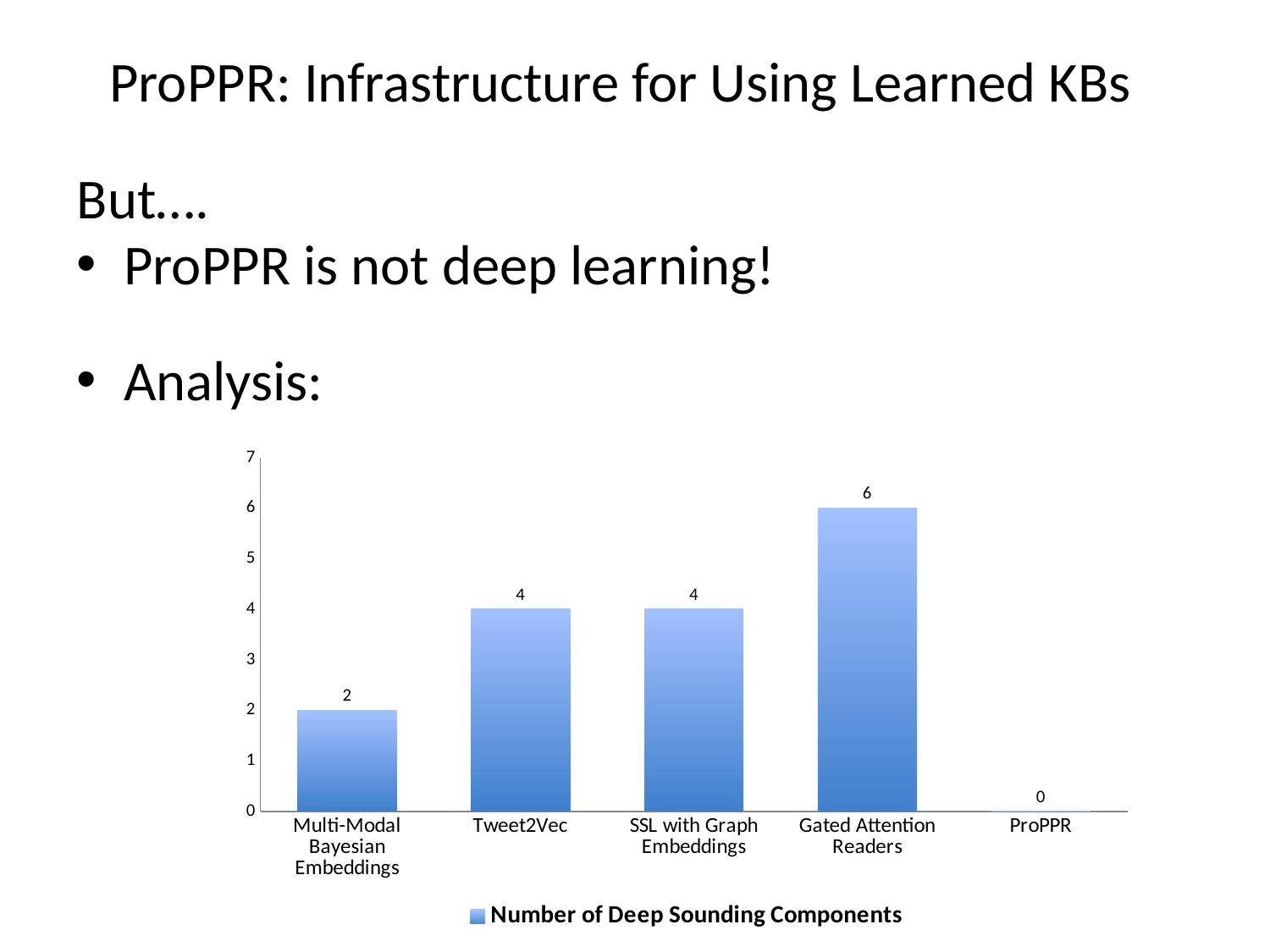
What kind of chart is shown on the slide? bar chart What is the difference between the values for Gated Attention Readers and Multi-Modal Bayesian Embeddings? 4 Which is larger, the value for SSL with Graph Embeddings or the value for Multi-Modal Bayesian Embeddings? SSL with Graph Embeddings Which category has the highest value? Gated Attention Readers Which category has the lowest value? ProPPR What is the value for ProPPR? 0 What is the value for Multi-Modal Bayesian Embeddings? 2 How many categories are shown on the x axis? 5 Is the value for Gated Attention Readers greater or less than 5? greater What is the value for Tweet2Vec? 4 What series name does the legend show? Number of Deep Sounding Components What is the value for Gated Attention Readers? 6